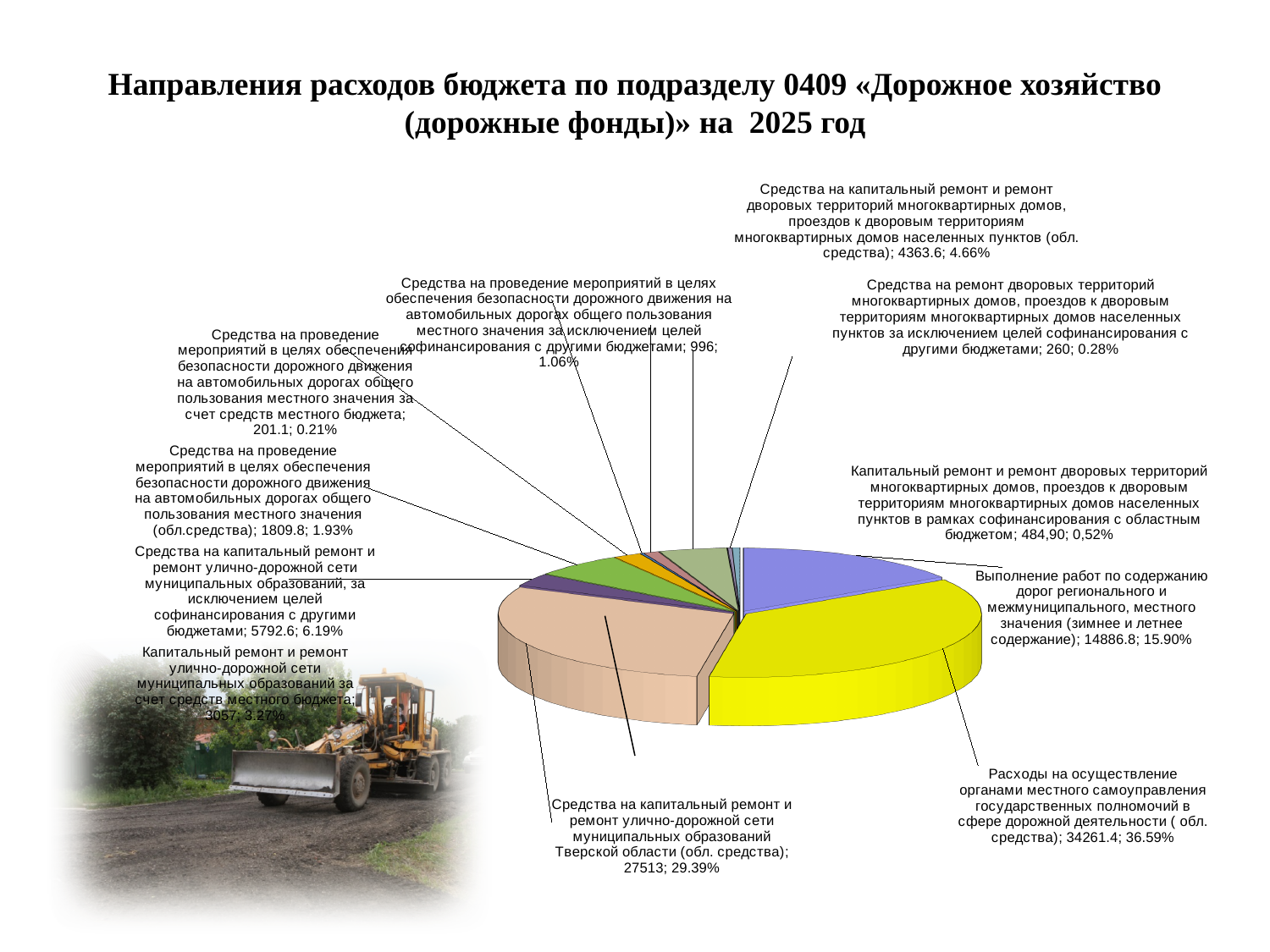
What value is shown for «Выполнение работ по содержанию дорог регионального и межмуниципального, местного значения (зимнее и летнее содержание)»? 14886.8 What percentage share is shown for «Средства на ремонт дворовых территорий многоквартирных домов, проездов к дворовым территориям многоквартирных домов населенных пунктов за исключением целей софинансирования с другими бюджетами»? 0.28% What value is shown for «Капитальный ремонт и ремонт улично-дорожной сети муниципальных образований за счет средств местного бюджета»? 3057 Which category has the smallest share of the pie? Средства на проведение мероприятий в целях обеспечения безопасности дорожного движения на автомобильных дорогах общего пользования местного значения за счет средств местного бюджета What is the difference between the value for «Расходы на осуществление органами местного самоуправления государственных полномочий в сфере дорожной деятельности (обл. средства)» (34261.4) and the value for «Средства на капитальный ремонт и ремонт улично-дорожной сети муниципальных образований Тверской области (обл. средства)» (27513)? 6748.4 Which category has the largest share of the pie? Расходы на осуществление органами местного самоуправления государственных полномочий в сфере дорожной деятельности (обл. средства) What kind of chart is shown on the slide? Pie chart What value is shown for «Средства на проведение мероприятий в целях обеспечения безопасности дорожного движения на автомобильных дорогах общего пользования местного значения (обл.средства)»? 1809.8 How many slices does the pie chart have? 11 Which is larger: the value for «Средства на капитальный ремонт и ремонт улично-дорожной сети муниципальных образований, за исключением целей софинансирования с другими бюджетами» or the value for «Средства на капитальный ремонт и ремонт дворовых территорий многоквартирных домов, проездов к дворовым территориям многоквартирных домов населенных пунктов (обл. средства)»? Средства на капитальный ремонт и ремонт улично-дорожной сети муниципальных образований, за исключением целей софинансирования с другими бюджетами What year does the slide title say the budget expenditure directions are for? 2025 What percentage share is shown for «Средства на капитальный ремонт и ремонт улично-дорожной сети муниципальных образований Тверской области (обл. средства)»? 29.39%